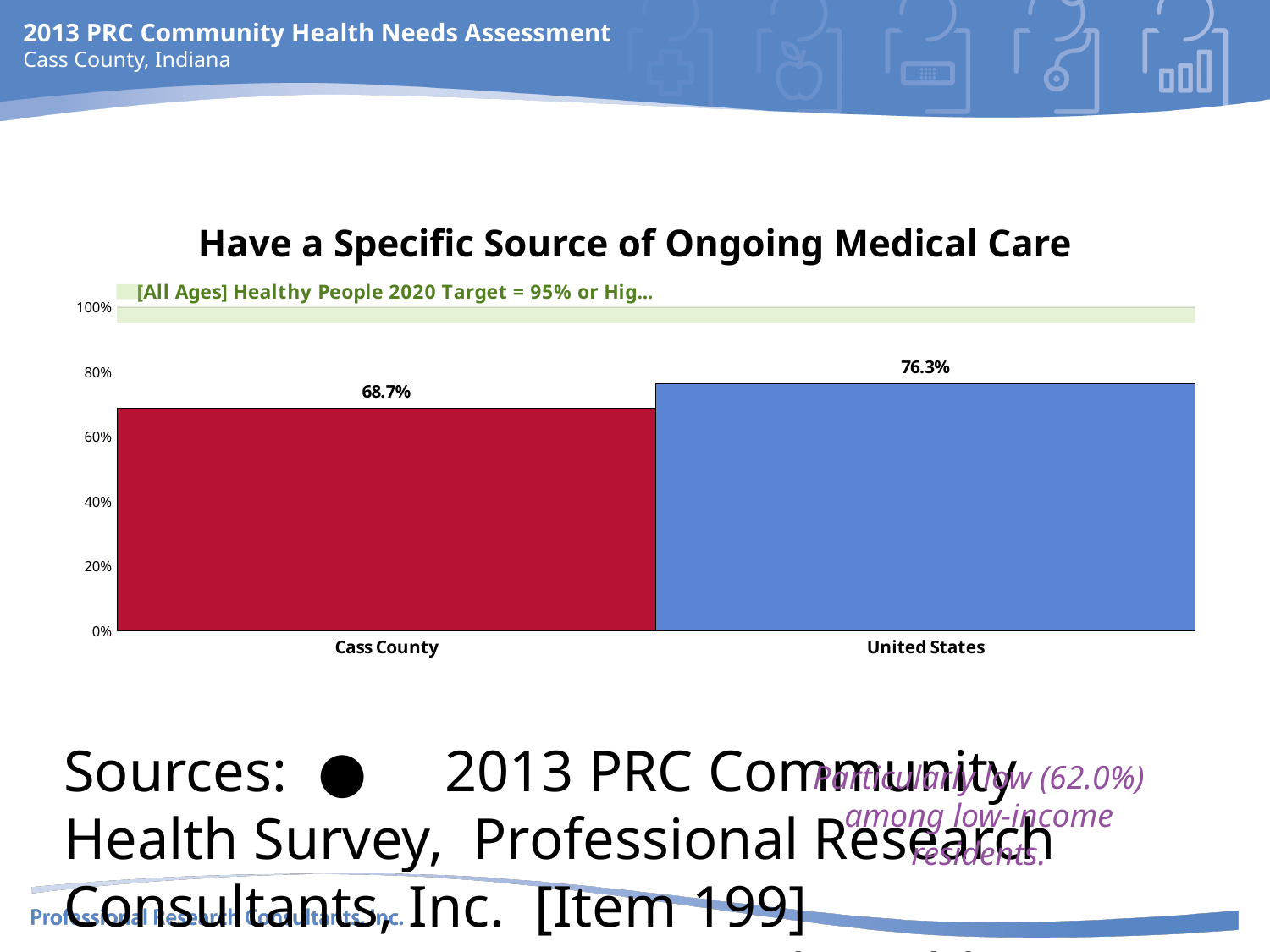
Is the value for United States greater or less than 60%? greater What is the value for United States? 76.3% What is the difference between the United States value and the Cass County value? 7.6% Which is larger, the value for Cass County or the value for United States? United States What kind of chart is shown? bar chart Is the value for Cass County greater or less than 80%? less Which category has the lowest value? Cass County What is the value for Cass County? 68.7% How many categories are shown on the x axis? 2 What is the Healthy People 2020 Target shown in the legend? 95% What is the title of the chart? Have a Specific Source of Ongoing Medical Care Which category has the highest value? United States